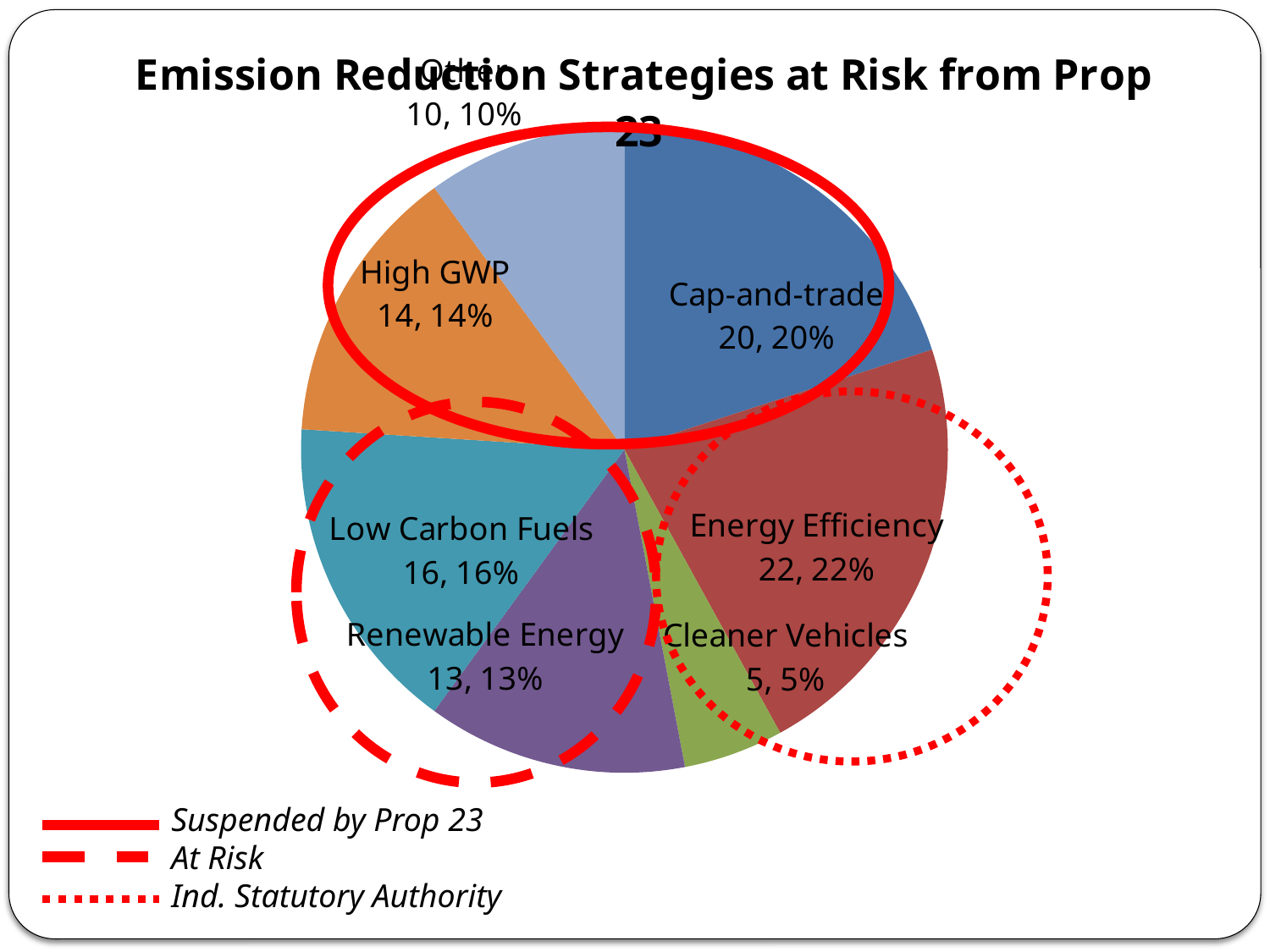
Which category has the smallest slice of the pie? Cleaner Vehicles What is the value shown for Cap-and-trade? 20, 20% How many slices does the pie chart have? 7 What is the title of the chart? Emission Reduction Strategies at Risk from Prop 23 What is the value shown for Cleaner Vehicles? 5, 5% What is the difference between the values for Energy Efficiency and Cap-and-trade? 2 What share of the pie does Other represent? 10% What is the value shown for Energy Efficiency? 22, 22% What is the value shown for Low Carbon Fuels? 16, 16% What kind of chart is shown on the slide? Pie chart Which is larger, the value for High GWP or the value for Renewable Energy? High GWP Which category has the largest slice of the pie? Energy Efficiency